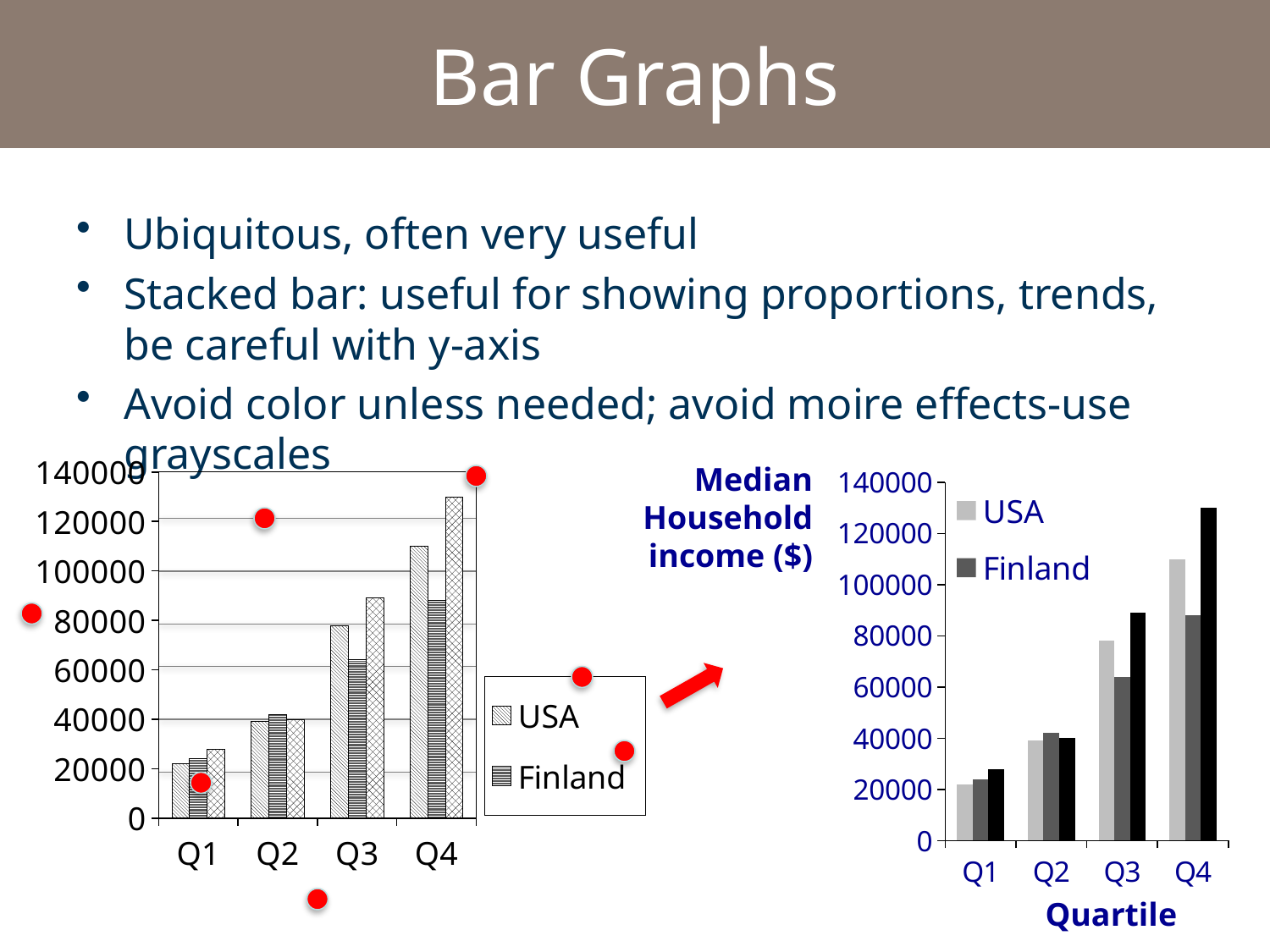
In the chart on the right, which is larger at Q4, USA or Finland? USA What kind of chart is the chart on the right of the slide? bar chart What is the x-axis title of the chart on the right? Quartile In the chart on the right, how many quartile categories are shown on the x axis? 4 In the chart on the right, in which quartile is the USA value highest? Q4 In the chart on the right, is the value for USA at Q1 greater or less than 40000? less In the chart on the right, which is larger at Q3, USA or Finland? USA In the chart on the right, is the value for Finland at Q3 greater or less than 80000? less In the chart on the right, is the value for Finland at Q4 greater or less than 80000? greater In the chart on the right, how many series does the legend list? 2 In the chart on the right, do the USA values rise or fall from Q1 to Q4? rise